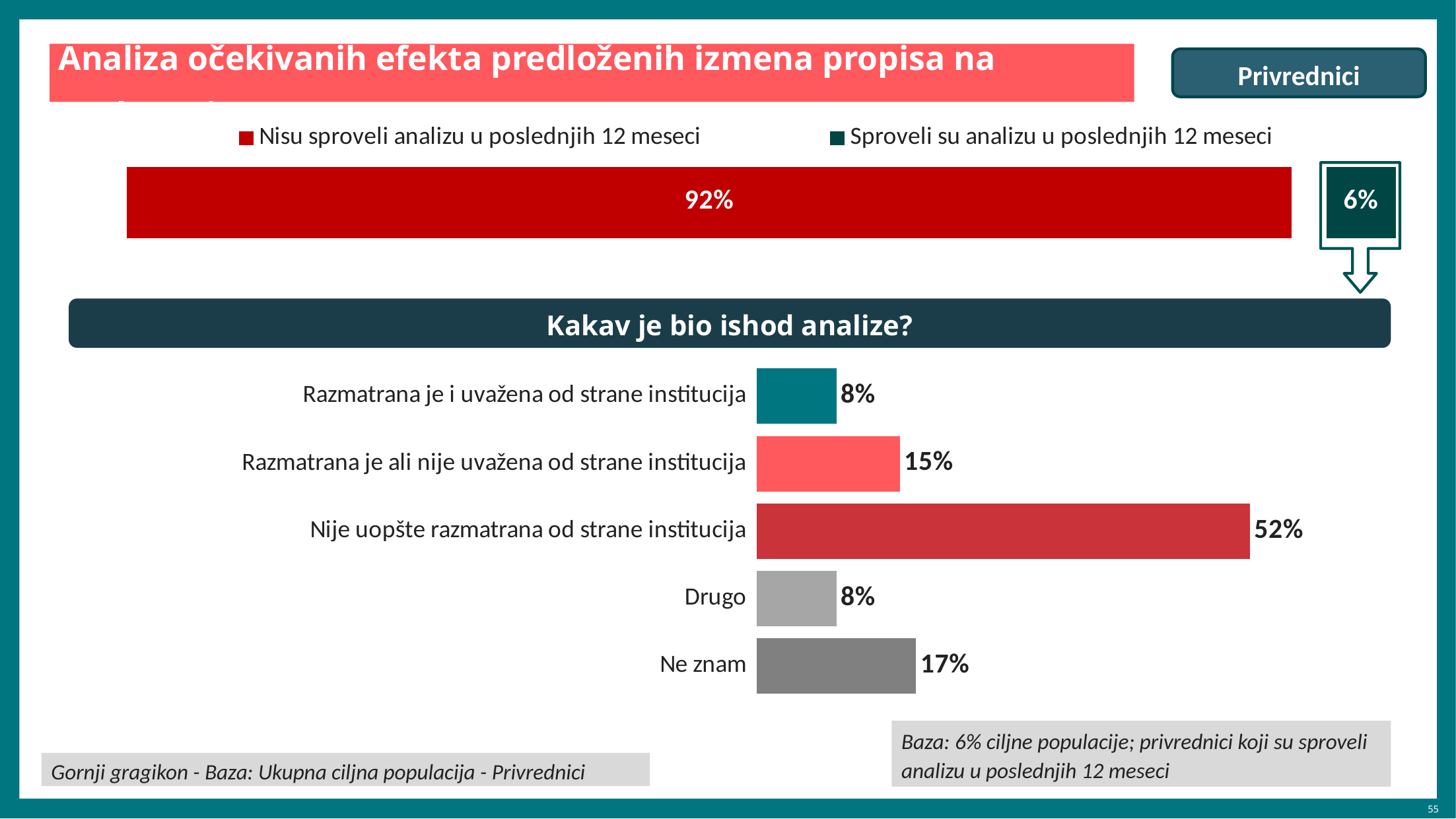
In the chart 'Kakav je bio ishod analize?', what is the value for 'Ne znam'? 17% In the chart 'Kakav je bio ishod analize?', which category has the highest value? Nije uopšte razmatrana od strane institucija In the top chart, how many series does the legend list? 2 In the chart 'Kakav je bio ishod analize?', how many categories are shown? 5 In the top chart, what percentage is shown for 'Sproveli su analizu u poslednjih 12 meseci'? 6% In the chart 'Kakav je bio ishod analize?', what is the value for 'Razmatrana je ali nije uvažena od strane institucija'? 15% In the chart 'Kakav je bio ishod analize?', which is larger: 'Razmatrana je ali nije uvažena od strane institucija' or 'Drugo'? Razmatrana je ali nije uvažena od strane institucija In the chart 'Kakav je bio ishod analize?', what is the difference between 'Nije uopšte razmatrana od strane institucija' and 'Ne znam'? 35% In the chart 'Kakav je bio ishod analize?', what is the value for 'Nije uopšte razmatrana od strane institucija'? 52% What type of chart is 'Kakav je bio ishod analize?'? Bar chart In the top chart, what is the difference between the 'Nisu sproveli analizu' and 'Sproveli su analizu' values? 86% In the top chart, what percentage is shown for 'Nisu sproveli analizu u poslednjih 12 meseci'? 92%